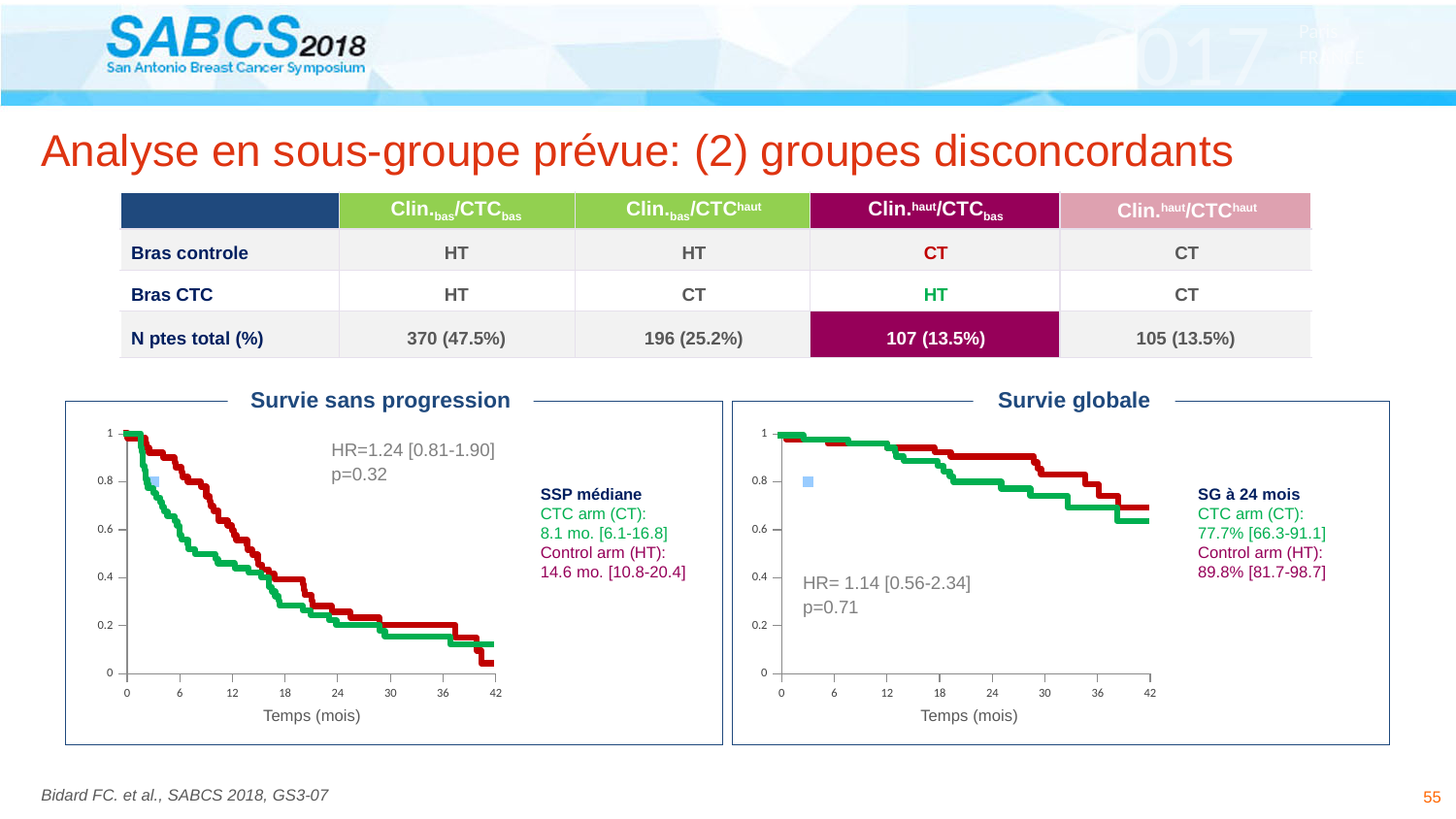
In the 'Survie globale' chart, is the value of the green (CTC arm) curve at 24 months greater or less than 0.6? greater In the 'Survie globale' chart, what is the overall survival at 24 months for the control arm (HT)? 89.8% [81.7-98.7] In the 'Survie sans progression' chart, what is the median PFS for the CTC arm (CT)? 8.1 mo. [6.1-16.8] In the 'Survie sans progression' chart, what is the median PFS for the control arm (HT)? 14.6 mo. [10.8-20.4] In the 'Survie sans progression' chart, do the survival curves rise or fall as time increases? fall In the 'Survie sans progression' chart, what is the difference in median PFS between the control arm (HT) and the CTC arm (CT)? 6.5 mo. What kind of chart is the 'Survie sans progression' chart? line chart (Kaplan-Meier survival curves) In the 'Survie globale' chart, what is the difference in 24-month overall survival between the control arm (HT) and the CTC arm (CT)? 12.1 percentage points In the 'Survie sans progression' chart, what is the hazard ratio shown? HR=1.24 [0.81-1.90] In the 'Survie globale' chart, what is the overall survival at 24 months for the CTC arm (CT)? 77.7% [66.3-91.1] In the 'Survie globale' chart, what is the p-value shown? p=0.71 In the 'Survie globale' chart, which arm has the higher overall survival at 24 months? Control arm (HT)